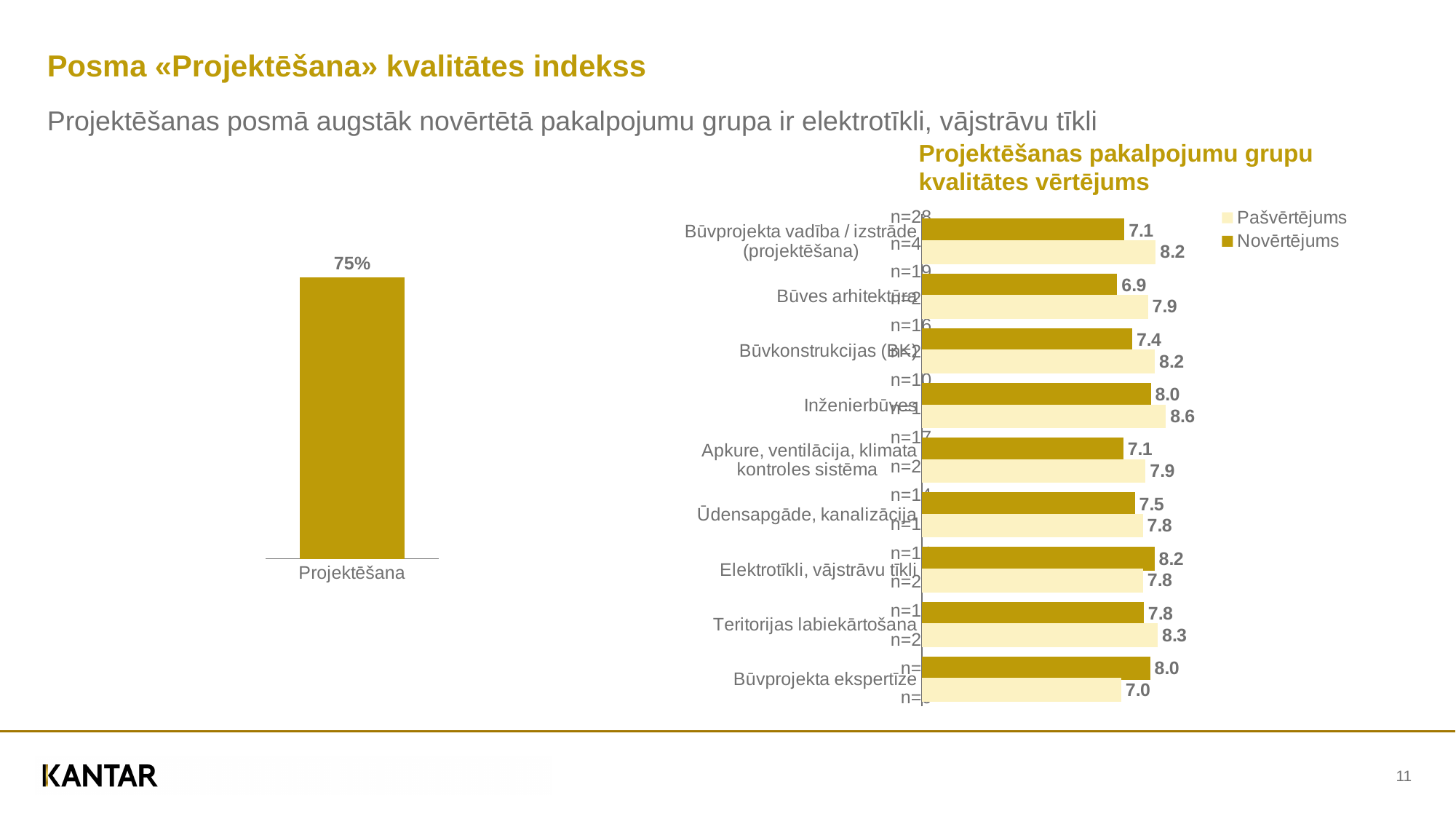
In the chart 'Projektēšanas pakalpojumu grupu kvalitātes vērtējums', which service group has the lowest Novērtējums value? Būves arhitektūra What type of chart is the chart titled 'Projektēšanas pakalpojumu grupu kvalitātes vērtējums'? bar chart In the chart 'Projektēšanas pakalpojumu grupu kvalitātes vērtējums', for Būvprojekta ekspertīze, which is larger: Novērtējums or Pašvērtējums? Novērtējums In the chart 'Projektēšanas pakalpojumu grupu kvalitātes vērtējums', which legend entry is shown in the darker gold colour? Novērtējums In the chart 'Projektēšanas pakalpojumu grupu kvalitātes vērtējums', which service group has the lowest Pašvērtējums value? Būvprojekta ekspertīze In the chart 'Projektēšanas pakalpojumu grupu kvalitātes vērtējums', what is the difference between the Pašvērtējums and Novērtējums values for Būvprojekta vadība / izstrāde (projektēšana)? 1.1 In the chart 'Projektēšanas pakalpojumu grupu kvalitātes vērtējums', what is the Novērtējums value for Elektrotīkli, vājstrāvu tīkli? 8.2 In the chart 'Projektēšanas pakalpojumu grupu kvalitātes vērtējums', which service group has the highest Pašvērtējums value? Inženierbūves In the chart 'Projektēšanas pakalpojumu grupu kvalitātes vērtējums', how many service groups (categories) are shown? 9 In the left chart, what is the value shown for Projektēšana? 75% In the chart 'Projektēšanas pakalpojumu grupu kvalitātes vērtējums', how many series does the legend list? 2 In the chart 'Projektēšanas pakalpojumu grupu kvalitātes vērtējums', what is the Pašvērtējums value for Inženierbūves? 8.6